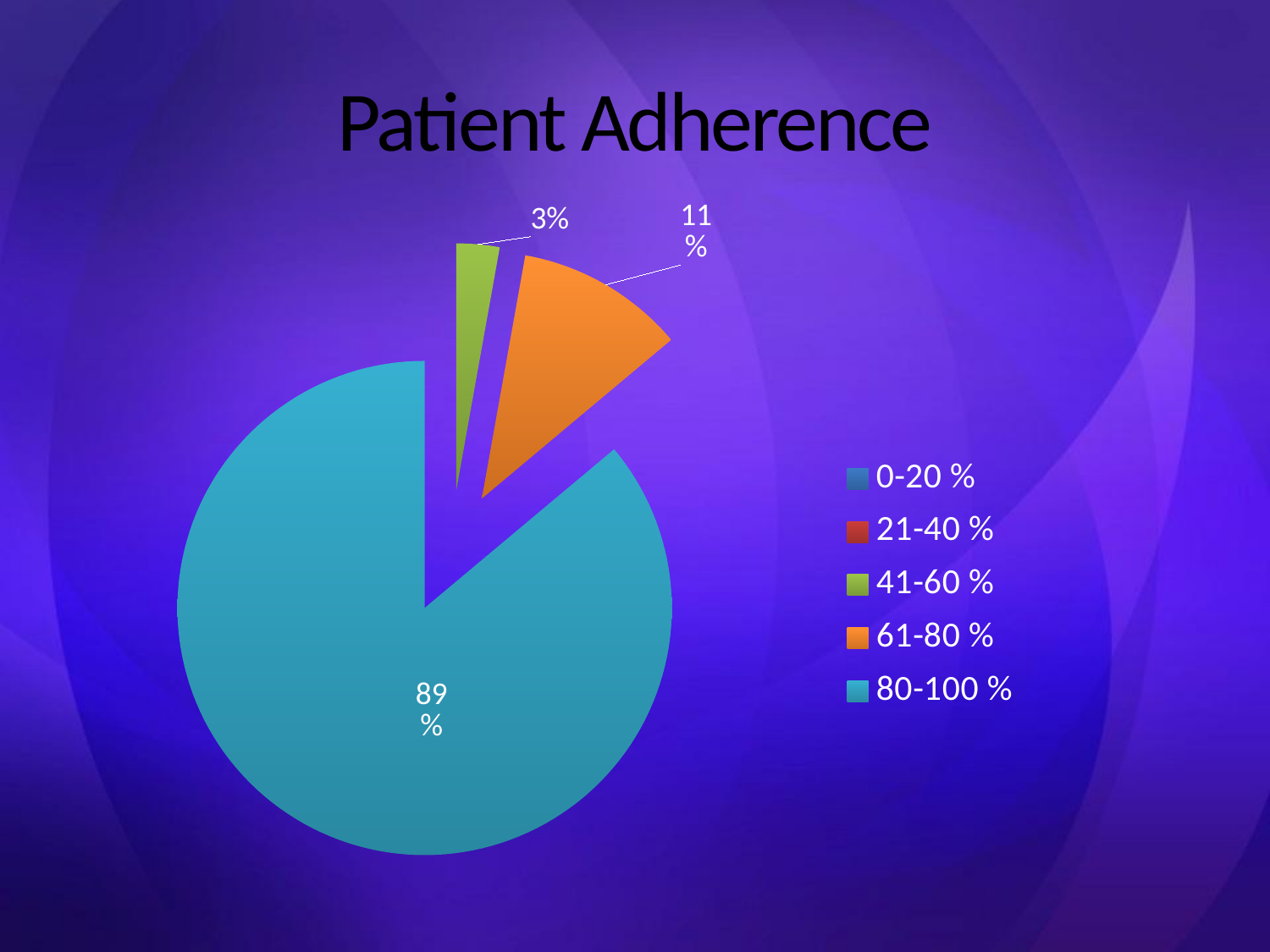
How many categories does the legend list? 5 How many percentage points larger is the 80-100 % slice than the 61-80 % slice? 78 Of the slices with printed labels, which category has the smallest share? 41-60 % What percentage is shown for the 41-60 % slice? 3% What type of chart is shown on the slide? Pie chart What share of the pie does the 80-100 % category have? 89% Which category has the largest slice of the pie? 80-100 % What colour represents the 61-80 % category in the legend? Orange Which slice is larger, 61-80 % or 41-60 %? 61-80 % How many percentage points larger is the 61-80 % slice than the 41-60 % slice? 8 What percentage is shown for the 61-80 % slice? 11% What is the title of the chart? Patient Adherence